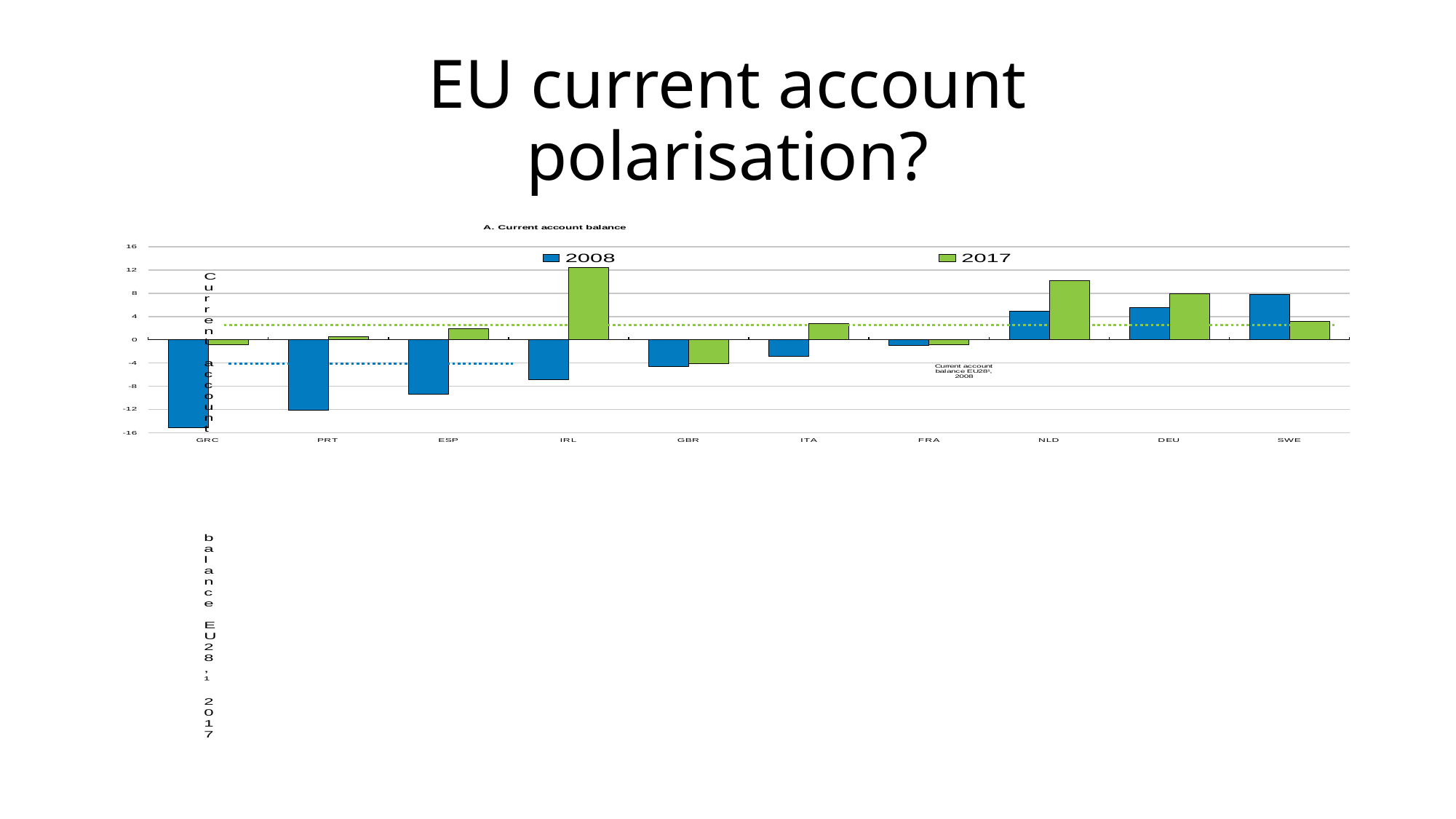
Which is larger, the 2017 value for IRL or the 2017 value for DEU? IRL How many series does the legend of the chart list? 2 Do the 2008 values generally rise or fall moving from GRC to SWE along the x axis? rise What is the title of the chart? A. Current account balance Which country has the highest 2008 current account balance? SWE Is the 2008 value for ESP greater or less than -8? less Is the 2008 value for GRC greater or less than -12? less What kind of chart is shown on the slide? bar chart How many countries are shown on the x axis of the chart? 10 Which country has the highest 2017 current account balance? IRL Is the 2017 value for NLD greater or less than 8? greater Which country has the lowest 2008 current account balance? GRC